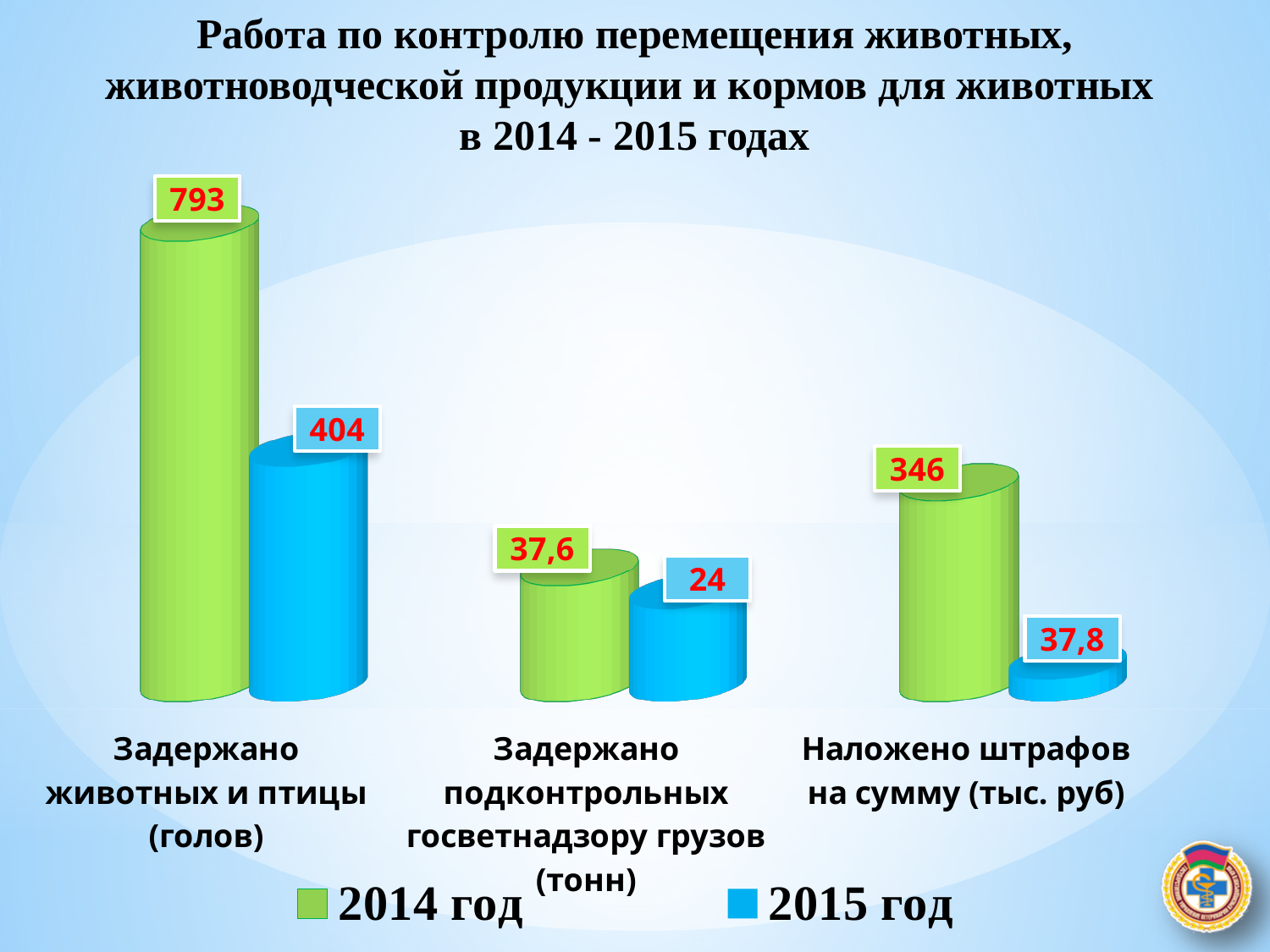
What kind of chart is shown on the slide? Bar chart What is the difference between the 2014 год and 2015 год values for «Наложено штрафов на сумму (тыс. руб)»? 308,2 What is the value for 2015 год in the category «Наложено штрафов на сумму (тыс. руб)»? 37,8 How many series does the legend list? 2 Which category has the lowest value for 2015 год? Задержано подконтрольных госветнадзору грузов (тонн) How many categories are shown on the chart? 3 What is the value for 2014 год in the category «Задержано животных и птицы (голов)»? 793 What is the value for 2015 год in the category «Задержано животных и птицы (голов)»? 404 Which is larger for «Задержано подконтрольных госветнадзору грузов (тонн)»: the 2014 год value or the 2015 год value? 2014 год What is the value for 2014 год in the category «Задержано подконтрольных госветнадзору грузов (тонн)»? 37,6 Which category has the highest value for 2014 год? Задержано животных и птицы (голов) What is the difference between the 2014 год and 2015 год values for «Задержано животных и птицы (голов)»? 389